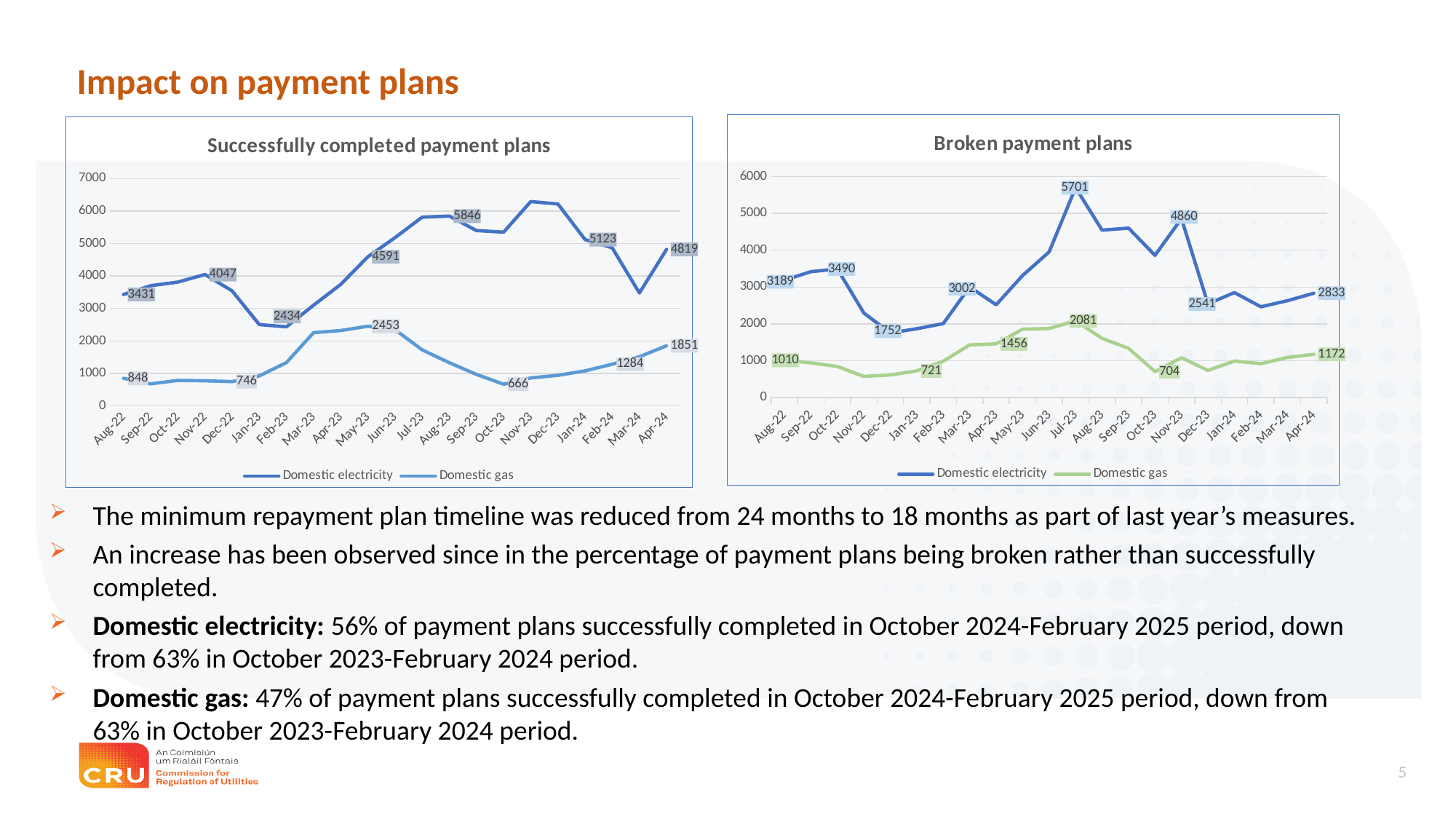
In the 'Successfully completed payment plans' chart, what is the value for Domestic electricity in Aug-22? 3431 In the 'Successfully completed payment plans' chart, which series has the larger value in Apr-24, Domestic electricity or Domestic gas? Domestic electricity In the 'Successfully completed payment plans' chart, what is the value for Domestic gas in Apr-24? 1851 In the 'Broken payment plans' chart, what is the difference between Domestic electricity and Domestic gas in Apr-24? 1661 How many series does the legend of the 'Broken payment plans' chart list? 2 In the 'Broken payment plans' chart, what is the value for Domestic gas in Aug-22? 1010 In the 'Successfully completed payment plans' chart, is the value for Domestic electricity in Nov-23 greater or less than 6000? greater How many months are shown on the x axis of the 'Successfully completed payment plans' chart? 21 In the 'Broken payment plans' chart, what is the value for Domestic electricity in Apr-24? 2833 In the 'Successfully completed payment plans' chart, what is the difference between Domestic electricity and Domestic gas in Aug-22? 2583 In the 'Broken payment plans' chart, what is the highest labelled value for Domestic electricity? 5701 What type of chart is the 'Successfully completed payment plans' chart? Line chart